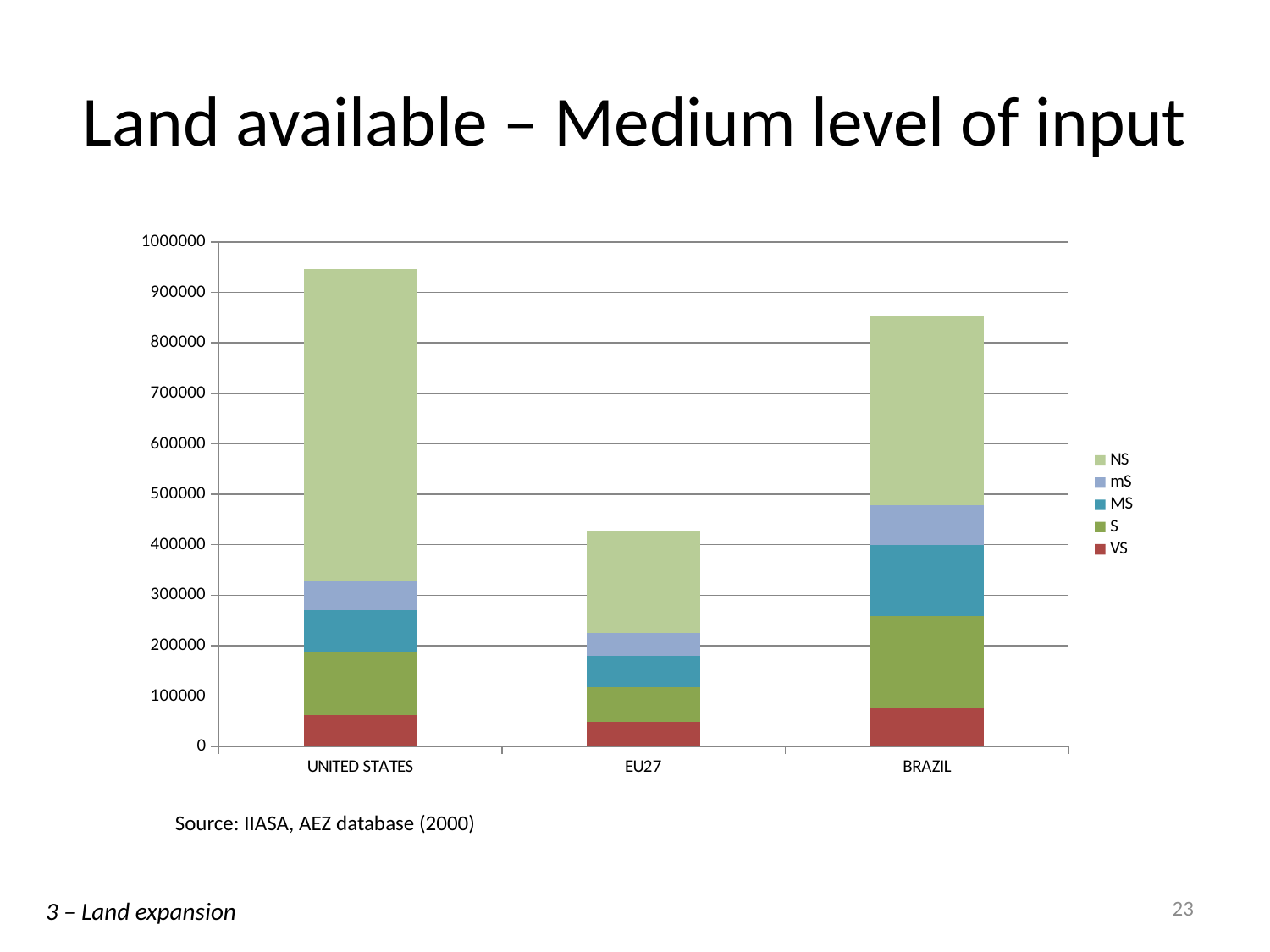
Is the total stacked value for UNITED STATES greater or less than 900000? greater How many categories (countries/regions) are shown on the x axis? 3 Which has the larger NS segment, UNITED STATES or BRAZIL? UNITED STATES What source is cited below the chart? IIASA, AEZ database (2000) Which has the larger S segment, UNITED STATES or BRAZIL? BRAZIL Which category has the shortest stacked bar overall? EU27 How many series does the legend list? 5 Is the total stacked value for BRAZIL greater or less than 800000? greater What kind of chart is shown on the slide? Stacked bar chart Which series is listed first (at the top) in the legend? NS Is the total stacked value for EU27 greater or less than 500000? less Which category has the tallest stacked bar overall? UNITED STATES